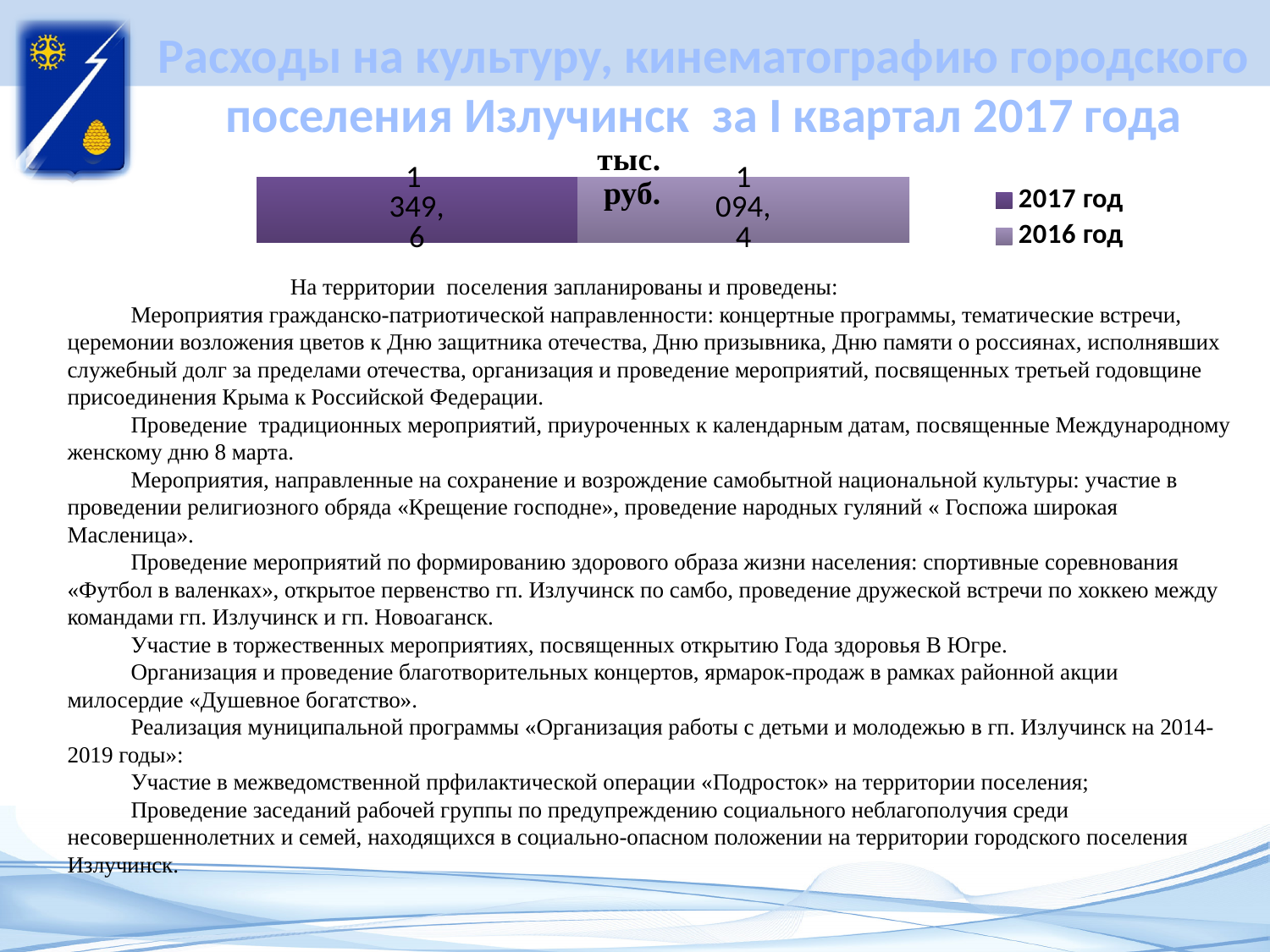
Is the value for 2017 год larger or smaller than the value for 2016 год? larger Which year has the lower value in the chart? 2016 год What is the difference between the 2017 год and 2016 год values? 255,2 How many series does the legend list? 2 Which year has the higher value in the chart? 2017 год Which legend entry is shown in the darker purple colour? 2017 год What unit is shown in the chart title? тыс. руб. What kind of chart is shown on the slide? bar chart What is the value for 2017 год in the chart? 1 349,6 What is the value for 2016 год in the chart? 1 094,4